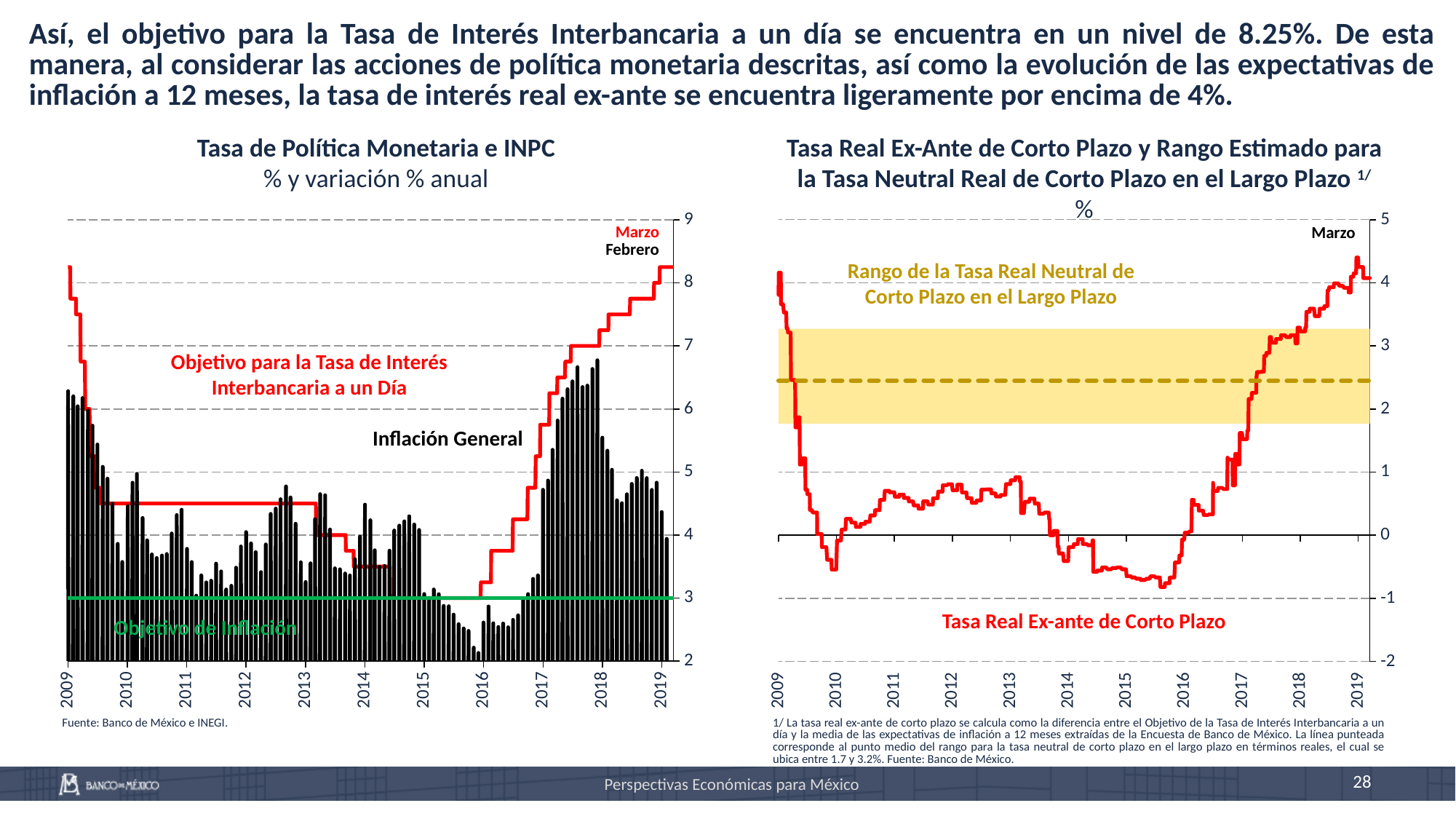
In the left-hand chart 'Tasa de Política Monetaria e INPC', is the 'Inflación General' value at the start of 2019 greater or less than 5? less In the left-hand chart 'Tasa de Política Monetaria e INPC', in which year does 'Inflación General' reach its highest value? 2017 In the right-hand chart, does the 'Tasa Real Ex-ante de Corto Plazo' rise or fall between 2016 and 2019? Rise In the right-hand chart, in which year does the 'Tasa Real Ex-ante de Corto Plazo' reach its lowest value? 2015 In the left-hand chart 'Tasa de Política Monetaria e INPC', which is higher in 2019: 'Objetivo para la Tasa de Interés Interbancaria a un Día' or 'Objetivo de Inflación'? Objetivo para la Tasa de Interés Interbancaria a un Día In the left-hand chart 'Tasa de Política Monetaria e INPC', is the value of 'Objetivo para la Tasa de Interés Interbancaria a un Día' in 2019 greater or less than 8? greater How many year labels are shown on the x axis of the left-hand chart 'Tasa de Política Monetaria e INPC'? 11 In the right-hand chart, is the 'Tasa Real Ex-ante de Corto Plazo' in March 2019 greater or less than 3? greater What kind of chart is the right-hand chart, 'Tasa Real Ex-Ante de Corto Plazo y Rango Estimado para la Tasa Neutral Real de Corto Plazo en el Largo Plazo'? Line chart In the left-hand chart 'Tasa de Política Monetaria e INPC', what kind of chart is used for the 'Inflación General' series? Bar chart In the right-hand chart, what colour is the shaded band labelled 'Rango de la Tasa Real Neutral de Corto Plazo en el Largo Plazo'? Yellow